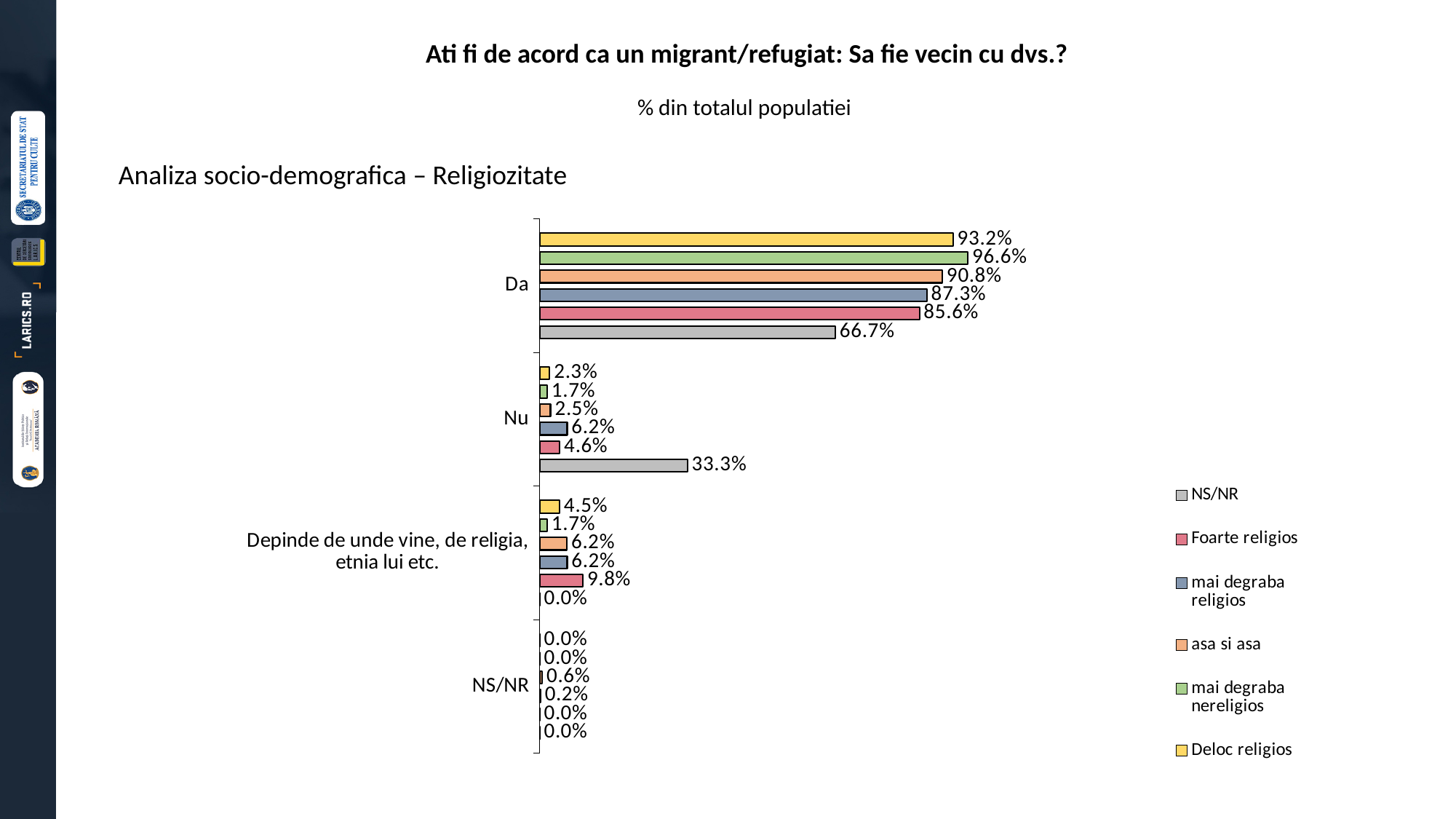
What is the value for 'NS/NR' in the 'Nu' category? 33.3% How many series does the legend list? 6 What type of chart is shown on the slide? bar chart What is the difference between 'Deloc religios' and 'Foarte religios' in the 'Da' category? 7.6% What is the value for 'asa si asa' in the 'NS/NR' category? 0.6% What is the value for 'mai degraba nereligios' in the 'Da' category? 96.6% Which series has the lowest value in the 'Da' category? NS/NR How many response categories are shown on the vertical axis? 4 Which series has the highest value in the 'Da' category? mai degraba nereligios What is the value for 'Foarte religios' in the 'Depinde de unde vine, de religia, etnia lui etc.' category? 9.8% What is the subtitle shown under the chart title? % din totalul populatiei In the 'Nu' category, which is larger: 'mai degraba religios' or 'Foarte religios'? mai degraba religios